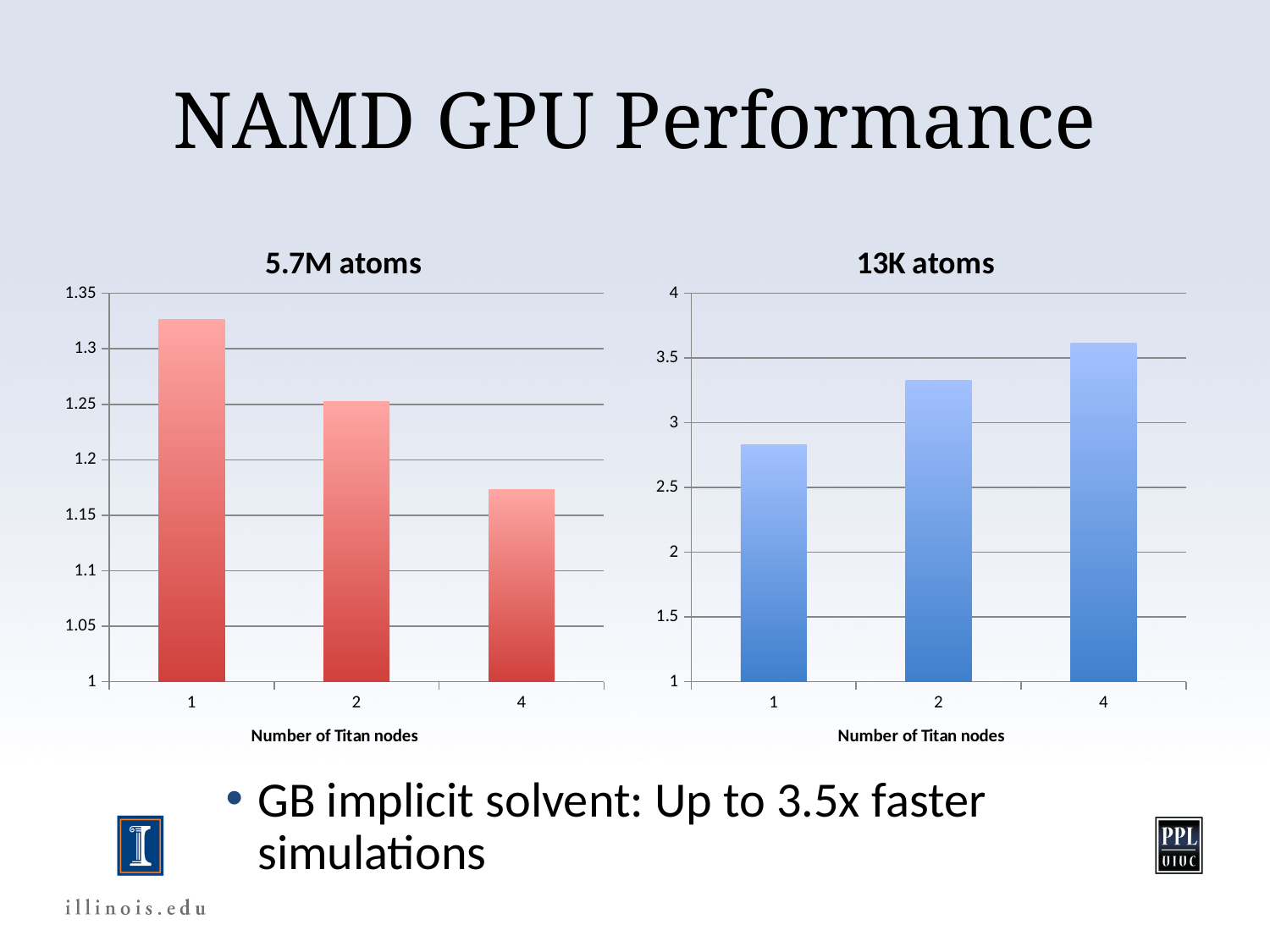
In the "13K atoms" chart, is the value for 4 Titan nodes greater or less than 3.5? greater In the "5.7M atoms" chart, do the values rise or fall as the number of Titan nodes increases? fall In the "5.7M atoms" chart, is the value for 4 Titan nodes greater or less than 1.2? less In the "13K atoms" chart, is the value for 1 Titan node greater or less than 3? less In the "13K atoms" chart, how many bars are plotted? 3 In the "5.7M atoms" chart, which number of Titan nodes has the lowest bar? 4 In the "13K atoms" chart, which number of Titan nodes has the lowest bar? 1 In the "5.7M atoms" chart, which number of Titan nodes has the highest bar? 1 What kind of chart is the "13K atoms" chart? bar chart In the "13K atoms" chart, which number of Titan nodes has the highest bar? 4 In the "13K atoms" chart, which is larger: the value for 2 Titan nodes or the value for 1 Titan node? 2 Titan nodes